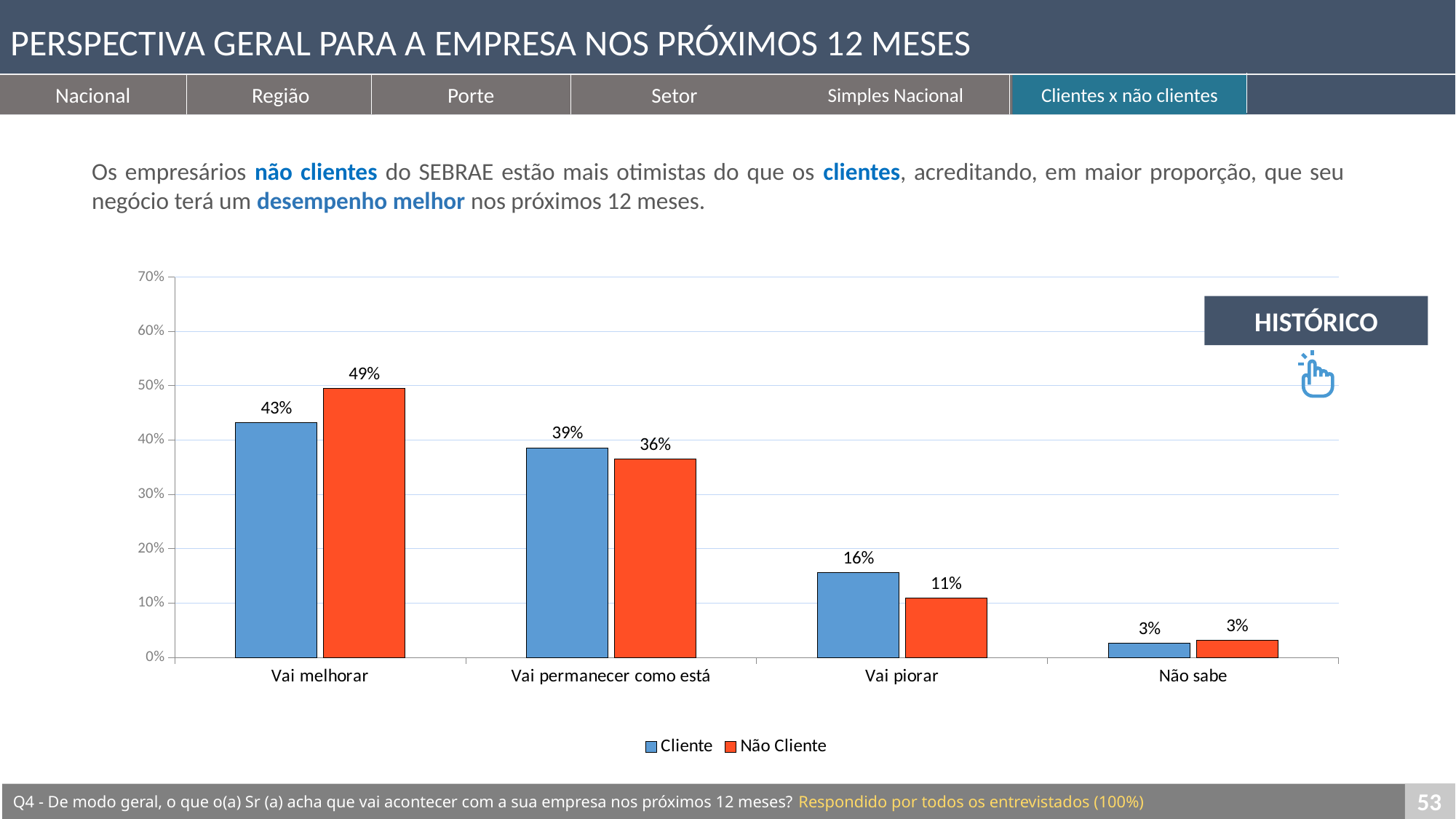
Is the value for Cliente in 'Vai permanecer como está' greater or less than 30%? greater How many series does the legend list? 2 What is the value for Cliente in the 'Vai melhorar' category? 43% What is the value for Não Cliente in the 'Vai piorar' category? 11% Which is larger in the 'Vai piorar' category, Cliente or Não Cliente? Cliente Which colour represents the Não Cliente series? Orange-red Which category has the lowest value for Cliente? Não sabe How many categories are shown on the x axis? 4 What is the difference between Não Cliente and Cliente in the 'Vai melhorar' category? 6% What is the value for Não Cliente in the 'Vai permanecer como está' category? 36% What kind of chart is shown on the slide? bar chart Which category has the highest value for Não Cliente? Vai melhorar